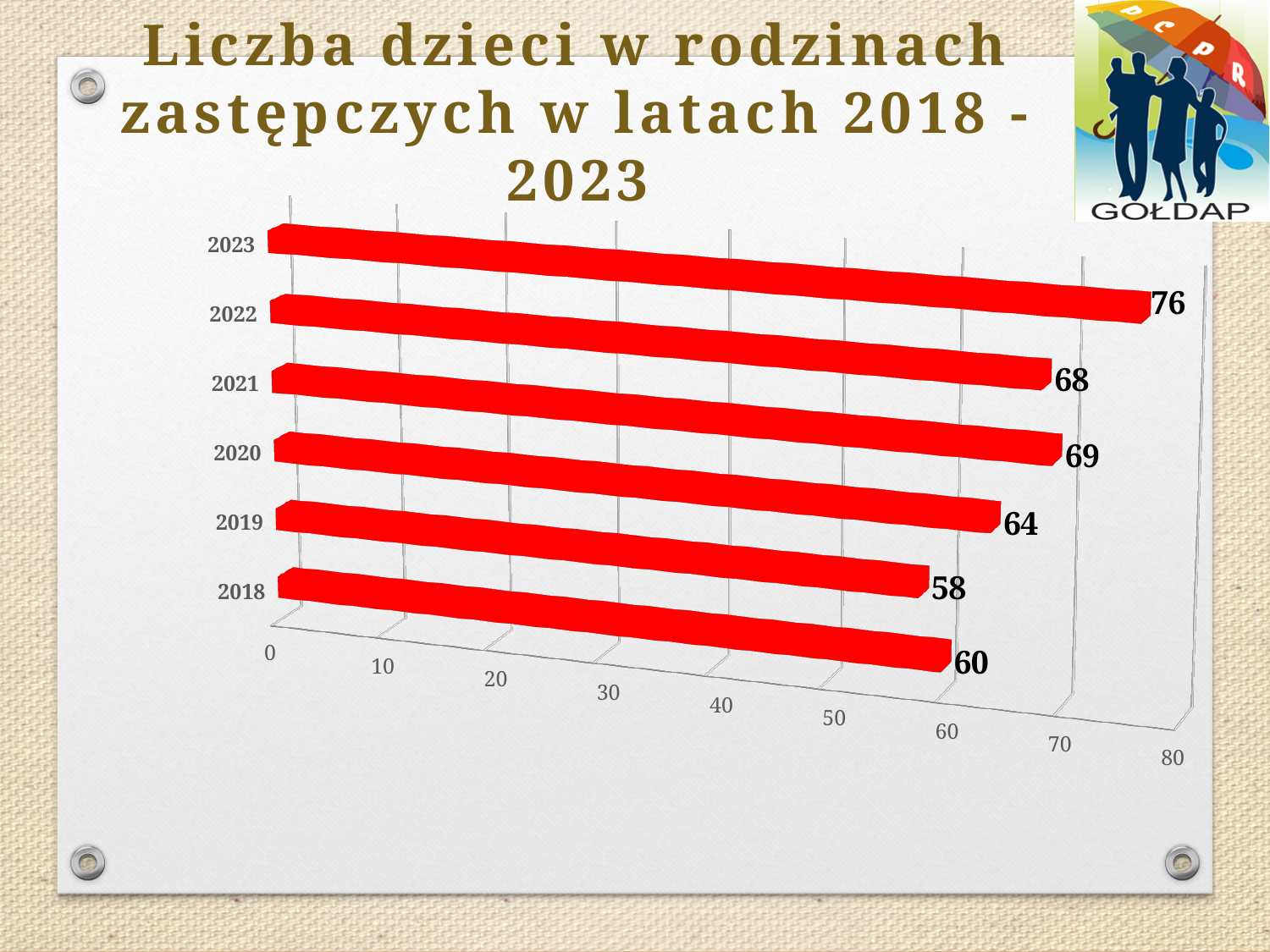
What is the title of the chart? Liczba dzieci w rodzinach zastępczych w latach 2018 - 2023 Which is larger, the value for 2021 or the value for 2022? 2021 What is the value for 2018? 60 What kind of chart is shown on the slide? Bar chart Which year has the highest value? 2023 What is the value for 2019? 58 What is the difference between the values for 2023 and 2018? 16 What is the value for 2021? 69 How many years are shown in the chart? 6 What is the difference between the values for 2020 and 2019? 6 Which year has the lowest value? 2019 What is the value for 2023? 76